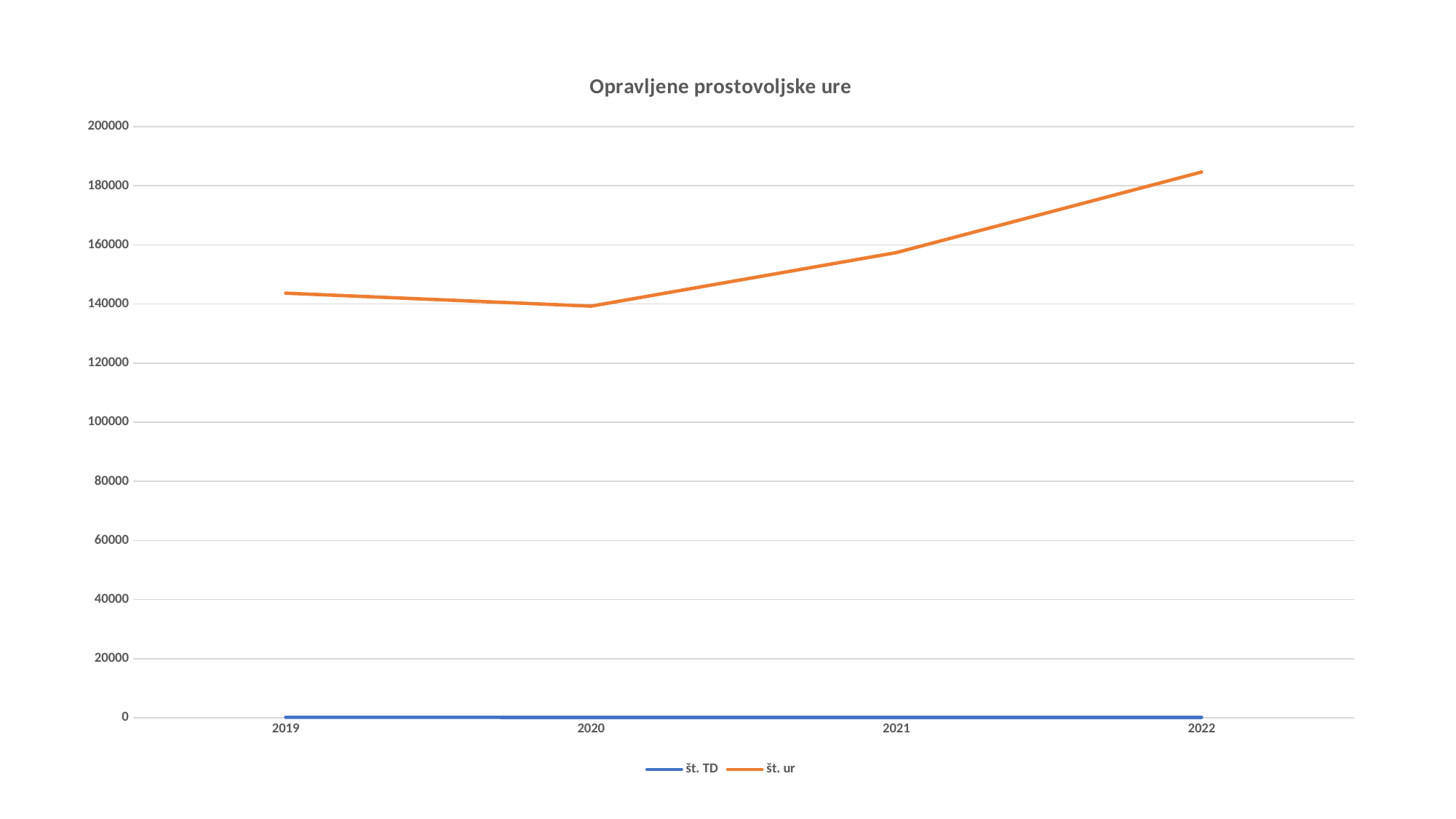
Which series is drawn in orange? št. ur In which year is the value of the št. ur series lowest? 2020 How many years are shown on the x axis? 4 What kind of chart is shown on the slide? line chart What is the title of the chart? Opravljene prostovoljske ure In which year is the value of the št. ur series highest? 2022 Is the value of št. ur for 2022 greater or less than 180000? greater Is the value of št. ur for 2021 greater or less than 160000? less Which is larger for the št. ur series, the value for 2019 or the value for 2021? 2021 How many series does the legend list? 2 Does the št. ur series rise or fall from 2020 to 2022? rise